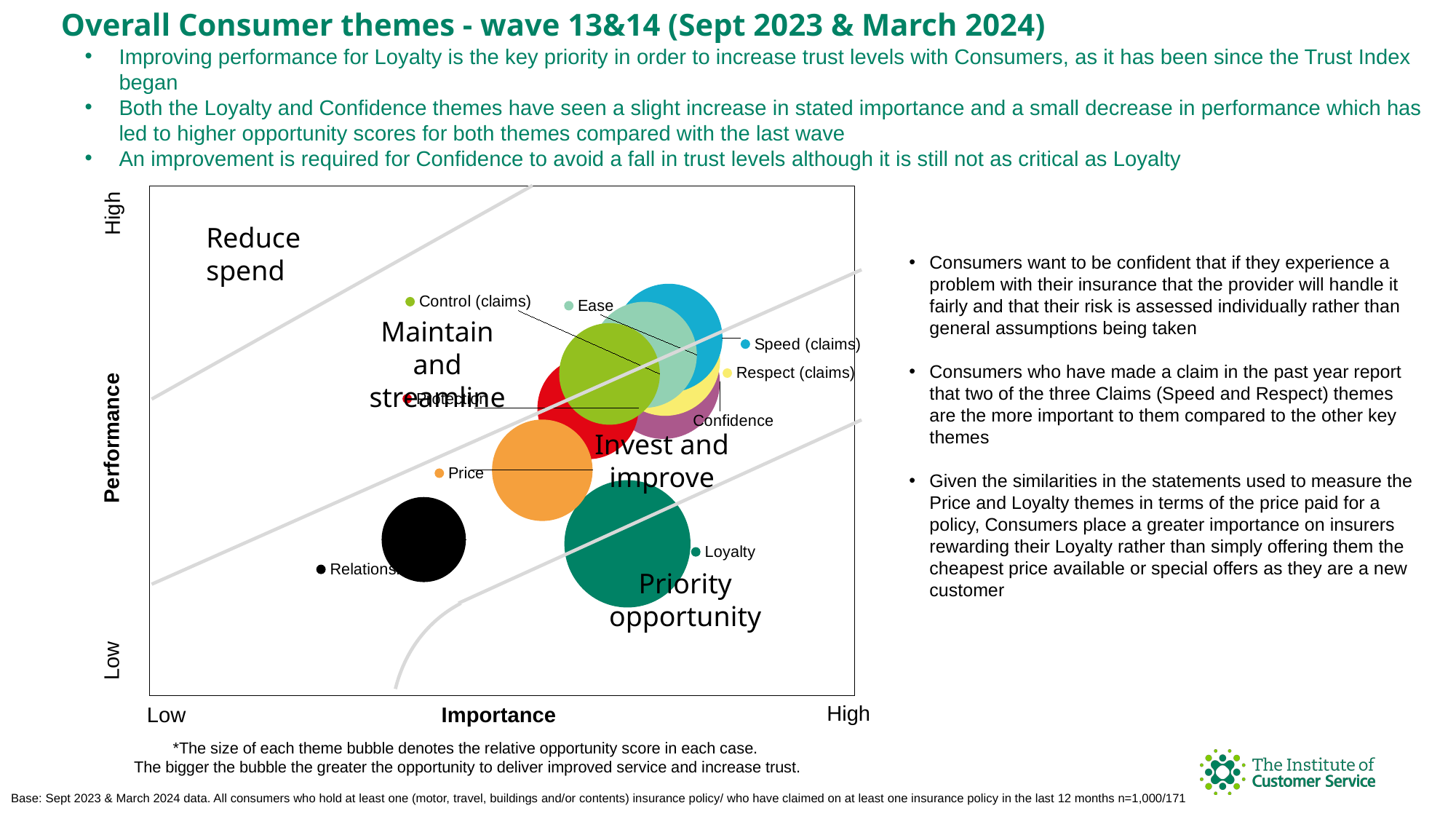
What kind of chart is shown on the slide? Bubble chart Which theme has higher performance on the chart, Speed (claims) or Loyalty? Speed (claims) Which theme has the largest bubble on the chart? Loyalty Which theme has higher importance on the chart, Price or Loyalty? Loyalty Which theme has higher importance on the chart, Relationship or Confidence? Confidence Which theme is plotted furthest to the left (lowest importance) on the chart? Relationship What colour is the Loyalty bubble on the chart? Dark green What is the label of the horizontal axis of the chart? Importance What is the label of the vertical axis of the chart? Performance Which theme is plotted in the 'Priority opportunity' area of the chart? Loyalty How many theme bubbles are plotted on the chart? 9